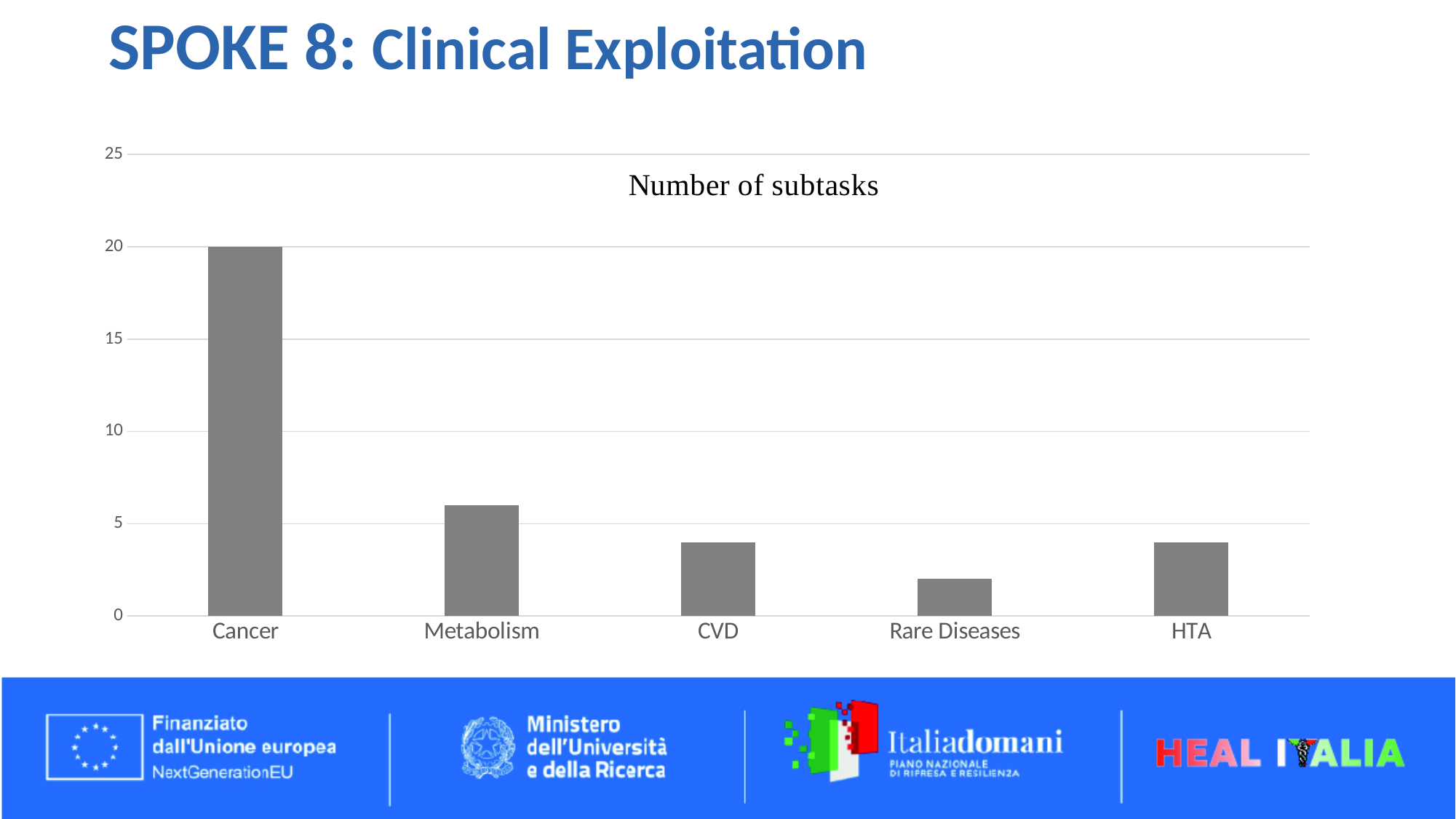
Which category has the lowest number of subtasks? Rare Diseases Is the value for CVD greater or less than 5? less Is the value for Rare Diseases greater or less than 5? less Which has more subtasks, Metabolism or Rare Diseases? Metabolism How many categories are shown on the x axis of the chart? 5 Which category has the highest number of subtasks? Cancer Is the value for HTA greater or less than 5? less What is the number of subtasks for Cancer? 20 What type of chart is shown on the slide? bar chart What is the title of the chart? Number of subtasks Which has more subtasks, Cancer or Metabolism? Cancer